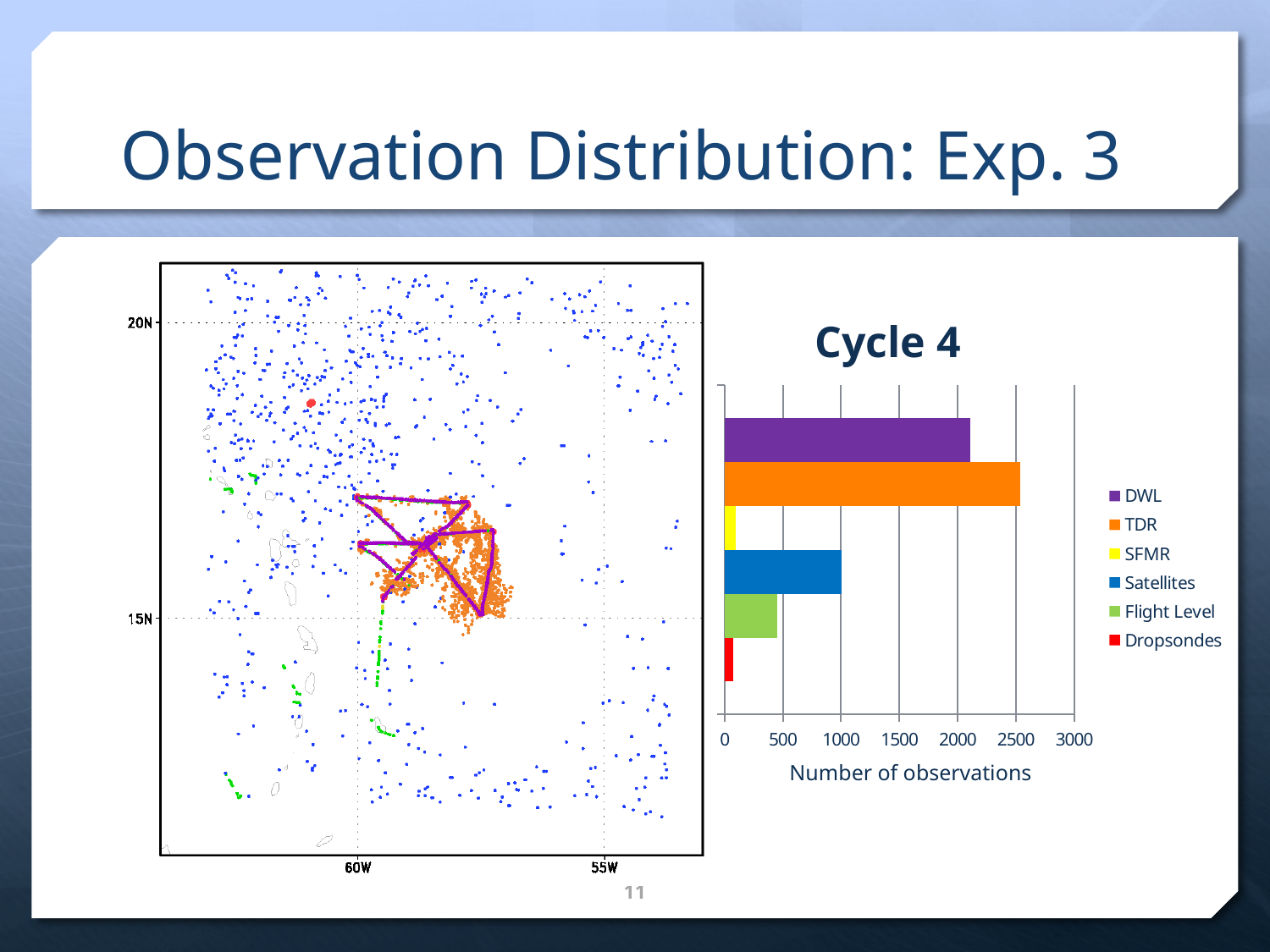
In the Cycle 4 chart, which observation type has the highest number of observations? TDR In the Cycle 4 chart, is the value for DWL greater or less than 2000? greater What is the title of the bar chart on the right of the slide? Cycle 4 In the Cycle 4 chart, is the value for SFMR greater or less than 500? less In the Cycle 4 chart, which has more observations, Satellites or Flight Level? Satellites In the Cycle 4 chart, how many series does the legend list? 6 In the Cycle 4 chart, what is the label on the horizontal axis? Number of observations In the Cycle 4 chart on the right, what kind of chart is shown? bar chart In the Cycle 4 chart, is the value for Dropsondes greater or less than 500? less In the Cycle 4 chart, which has more observations, DWL or Satellites? DWL